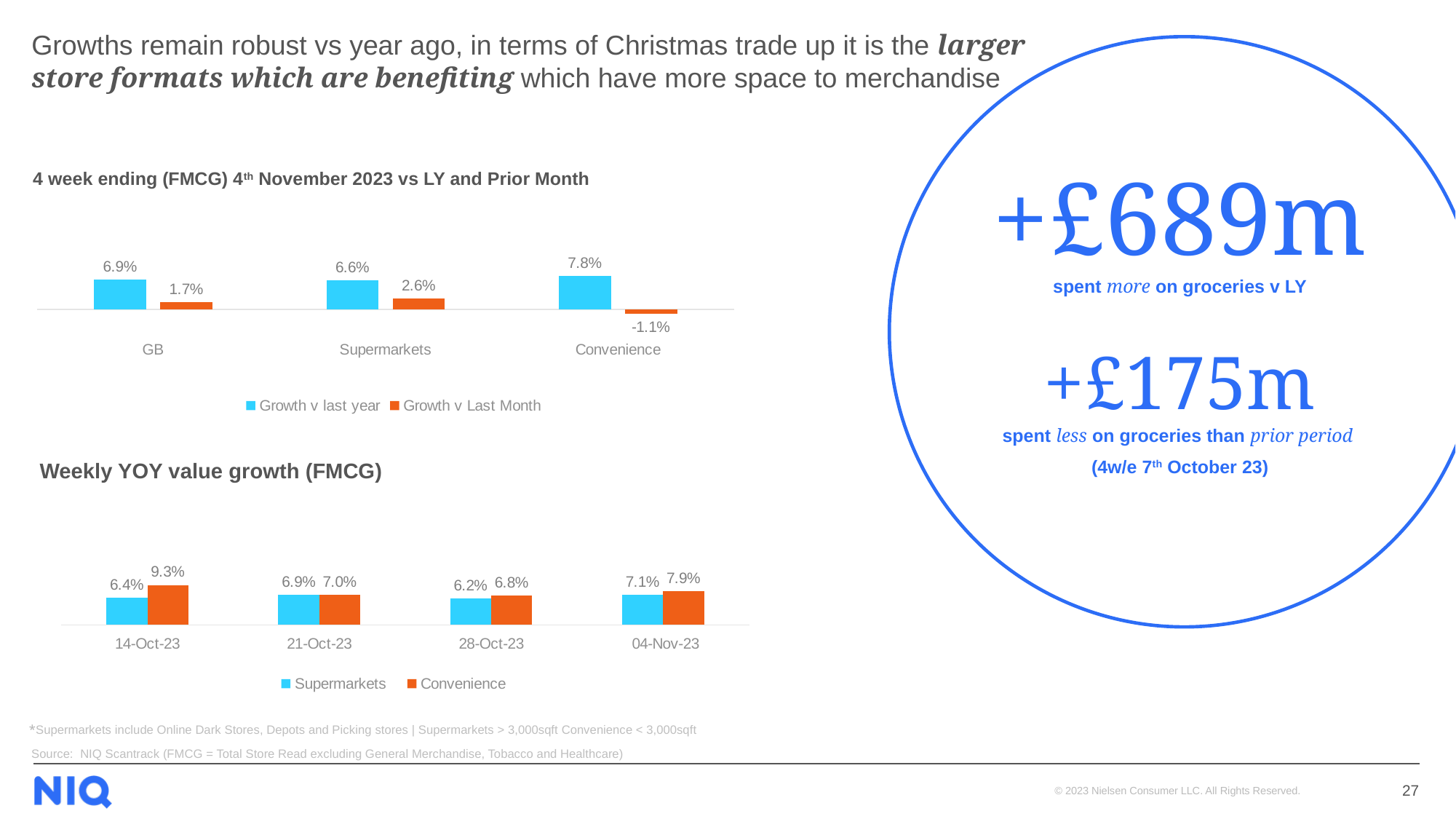
In the bottom chart (Weekly YOY value growth), what is the difference between the Convenience and Supermarkets values for 28-Oct-23? 0.6% In the top chart (4 week ending 4th November 2023), what is the Growth v last year value for Convenience? 7.8% In the bottom chart (Weekly YOY value growth), what is the Convenience value for 14-Oct-23? 9.3% In the top chart (4 week ending 4th November 2023), what is the Growth v Last Month value for GB? 1.7% In the bottom chart (Weekly YOY value growth), what is the Supermarkets value for 04-Nov-23? 7.1% What kind of chart is the bottom chart (Weekly YOY value growth)? Bar chart In the top chart (4 week ending 4th November 2023), which category has the lowest Growth v Last Month value? Convenience In the bottom chart (Weekly YOY value growth), which week has the lowest Supermarkets value? 28-Oct-23 In the top chart (4 week ending 4th November 2023), how many series does the legend list? 2 In the bottom chart (Weekly YOY value growth), how many weeks are shown on the x axis? 4 In the bottom chart (Weekly YOY value growth), which week has the highest Convenience value? 14-Oct-23 In the top chart (4 week ending 4th November 2023), what is the difference between the Growth v last year and Growth v Last Month values for Supermarkets? 4.0%